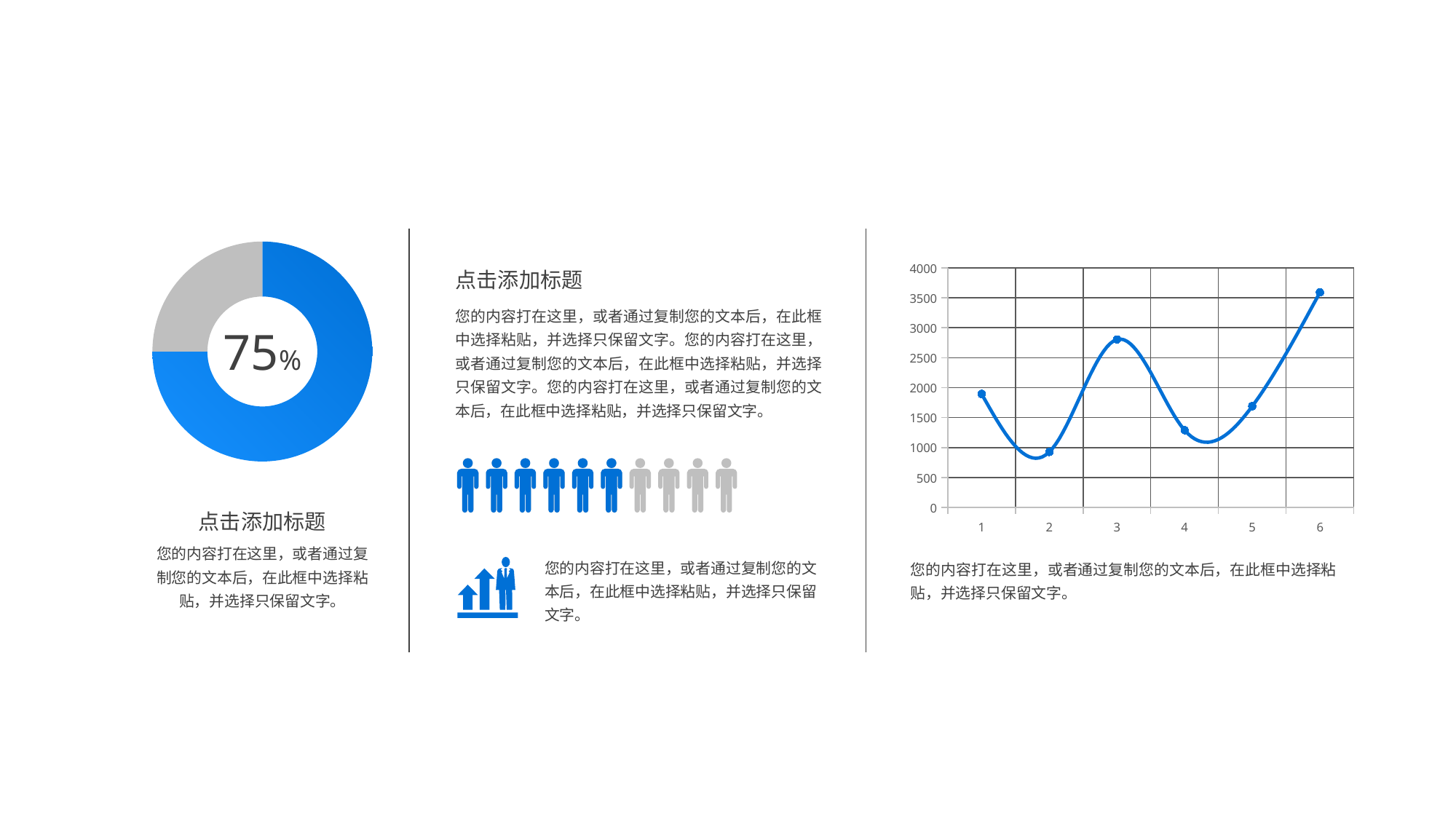
On the line chart on the right, which has the larger value, category 1 or category 4? Category 1 On the line chart on the right, what is the maximum value shown on the y axis? 4000 On the line chart on the right, which x-axis category has the lowest value? 2 What kind of chart is the chart on the left of the slide? Donut chart On the donut chart on the left, what percentage is shown in the centre? 75% On the line chart on the right, is the value at category 2 greater or less than 1000? less On the line chart on the right, do the values rise or fall from category 4 to category 6? Rise On the line chart on the right, how many data points are plotted? 6 On the line chart on the right, which x-axis category has the highest value? 6 On the line chart on the right, is the value at category 3 greater or less than 2500? greater On the line chart on the right, is the value at category 6 greater or less than 3500? greater What kind of chart is the chart on the right of the slide? Line chart